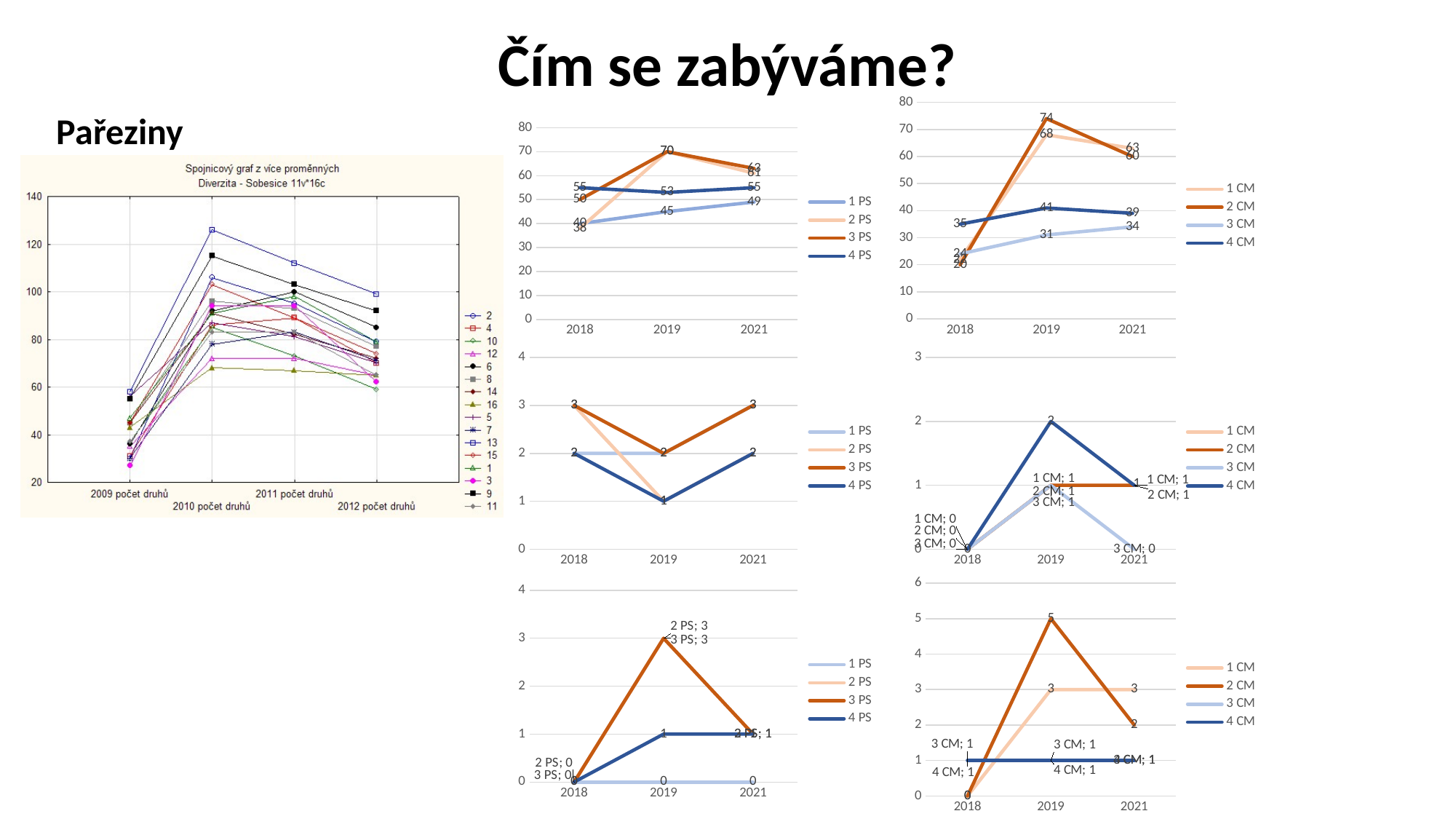
In the top-middle line chart (PS series, axis 0–80), what is the value for 1 PS in 2021? 49 In the bottom-middle line chart (PS series, axis 0–4), what is the value for 2 PS in 2019? 3 In the top-right line chart (CM series, axis 0–80), what is the difference between 3 CM in 2021 and 3 CM in 2018? 10 In the top-right line chart (CM series, axis 0–80), what is the value for 4 CM in 2019? 41 In the top-middle line chart (PS series, axis 0–80), does the 1 PS series rise or fall from 2018 to 2021? rise In the top-middle line chart (PS series, axis 0–80), what is the value for 4 PS in 2018? 55 In the middle-right line chart (CM series, axis 0–3), what is the value for 4 CM in 2019? 2 In the bottom-right line chart (CM series, axis 0–6), which is larger in 2021: 1 CM or 2 CM? 1 CM In the bottom-right line chart (CM series, axis 0–6), what is the value for 2 CM in 2019? 5 How many series does the legend of the top-right line chart (CM series) list? 4 How many entries does the legend of the left 'Pařeziny' chart list? 16 In the top-right line chart (CM series, axis 0–80), what is the highest labelled value shown? 74